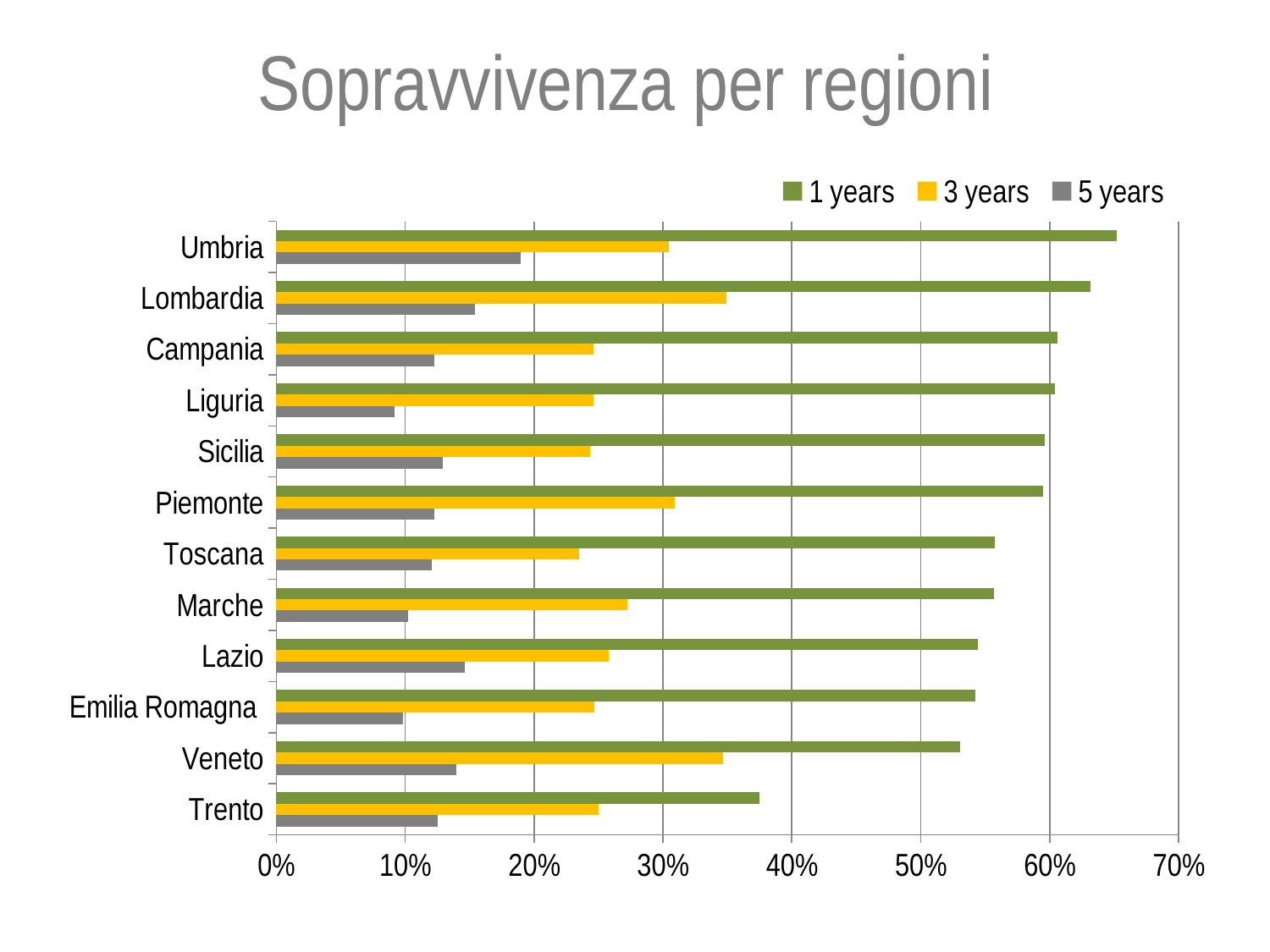
Do the 1 years values increase or decrease going down the chart from Umbria to Trento? decrease How many series does the legend list? 3 Which is larger, the 3 years value for Veneto or the 3 years value for Campania? Veneto How many regions are plotted on the chart? 12 Which region has the highest 1 years value? Umbria What is the title of the chart? Sopravvivenza per regioni Which region has the highest 5 years value? Umbria Is the 5 years value for Liguria greater or less than 10%? less Is the 3 years value for Lombardia greater or less than 30%? greater Which region has the lowest 1 years value? Trento What kind of chart is shown on the slide? Bar chart Is the 1 years value for Trento greater or less than 40%? less